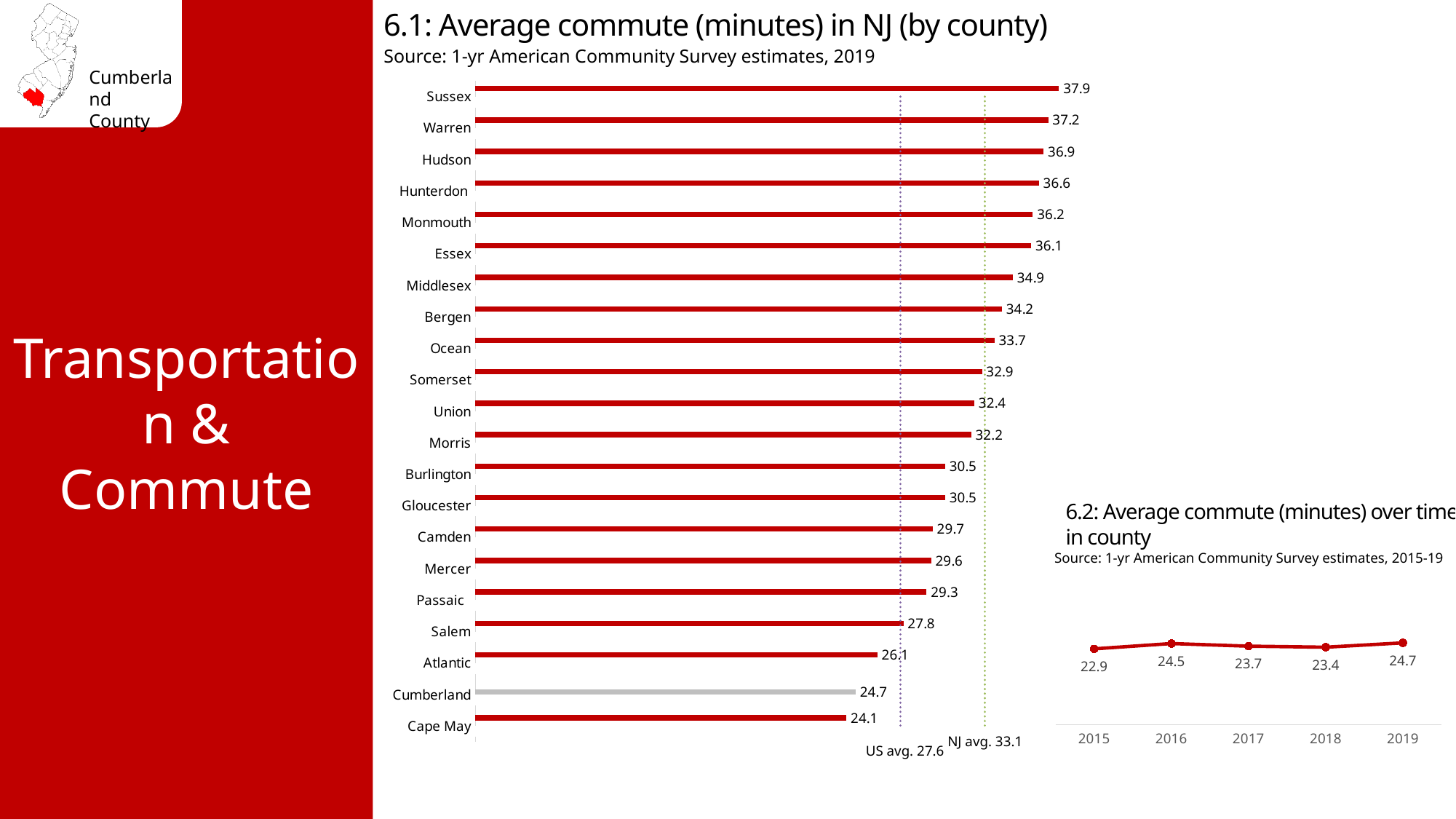
What kind of chart is chart 6.1? bar chart In chart 6.1, how many counties are shown? 21 In chart 6.2, what was the average commute in minutes in 2015? 22.9 In chart 6.1, what is the average commute in minutes for Cumberland? 24.7 In chart 6.2, which year had the highest average commute? 2019 In chart 6.1, which county has a longer average commute, Hudson or Bergen? Hudson In chart 6.2, what is the difference between the 2019 and 2015 average commute values? 1.8 In chart 6.1, which county has the highest average commute? Sussex In chart 6.1, what is the NJ average commute shown by the reference line? 33.1 In chart 6.1, what is the average commute in minutes for Sussex? 37.9 In chart 6.1, which county has the lowest average commute? Cape May In chart 6.1, what is the difference between the average commute for Sussex and Cape May? 13.8